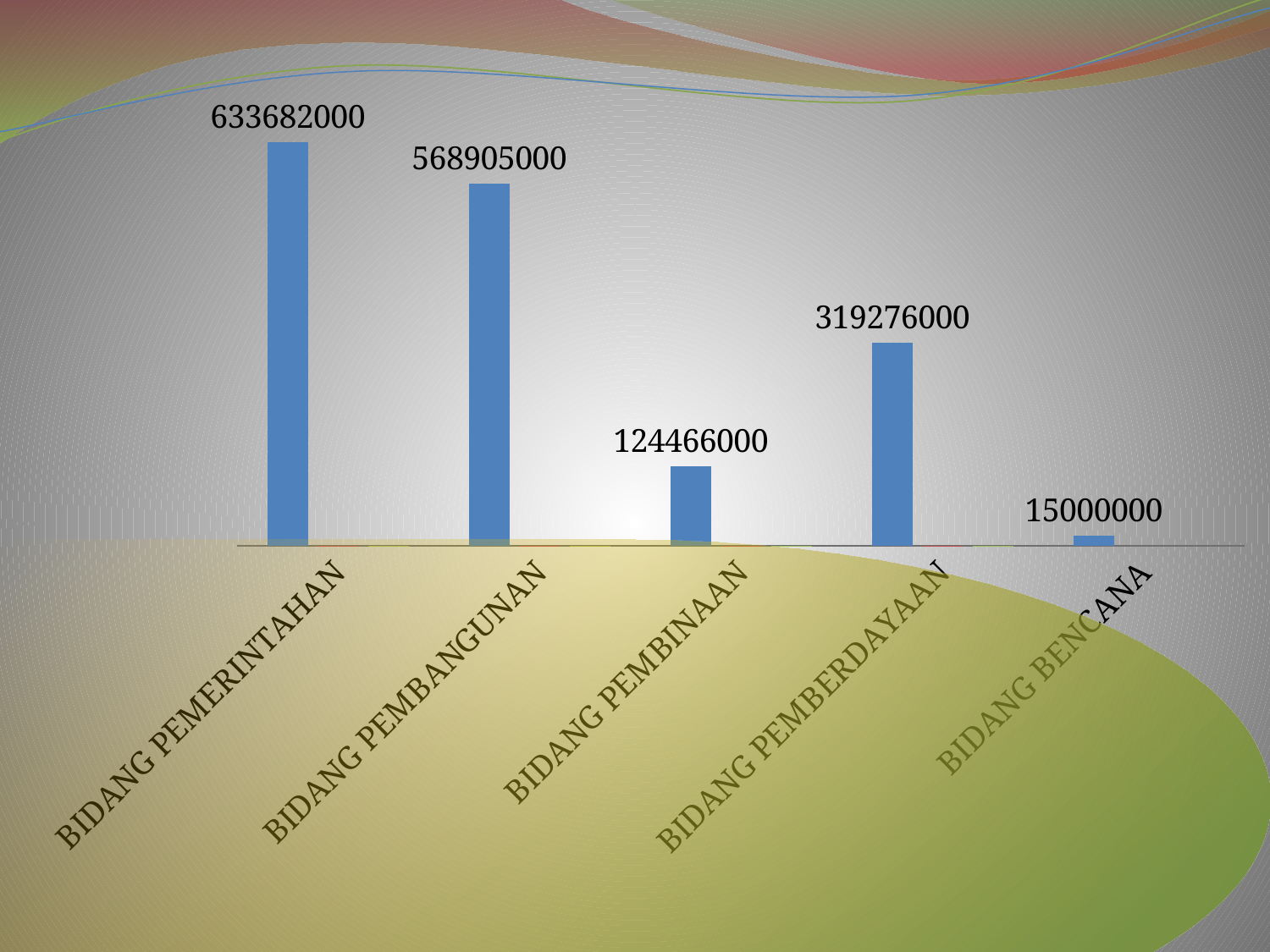
What kind of chart is shown on the slide? bar chart How many categories are shown in the chart? 5 Which is larger, the value for BIDANG PEMBERDAYAAN or the value for BIDANG PEMBINAAN? BIDANG PEMBERDAYAAN What is the difference between the values for BIDANG PEMBERDAYAAN and BIDANG PEMBINAAN? 194810000 What is the value for BIDANG PEMBERDAYAAN? 319276000 What is the value for BIDANG PEMERINTAHAN? 633682000 Which category has the highest value? BIDANG PEMERINTAHAN Which category has the lowest value? BIDANG BENCANA What is the difference between the values for BIDANG PEMERINTAHAN and BIDANG PEMBANGUNAN? 64777000 What is the value for BIDANG BENCANA? 15000000 What is the value for BIDANG PEMBINAAN? 124466000 What is the value for BIDANG PEMBANGUNAN? 568905000